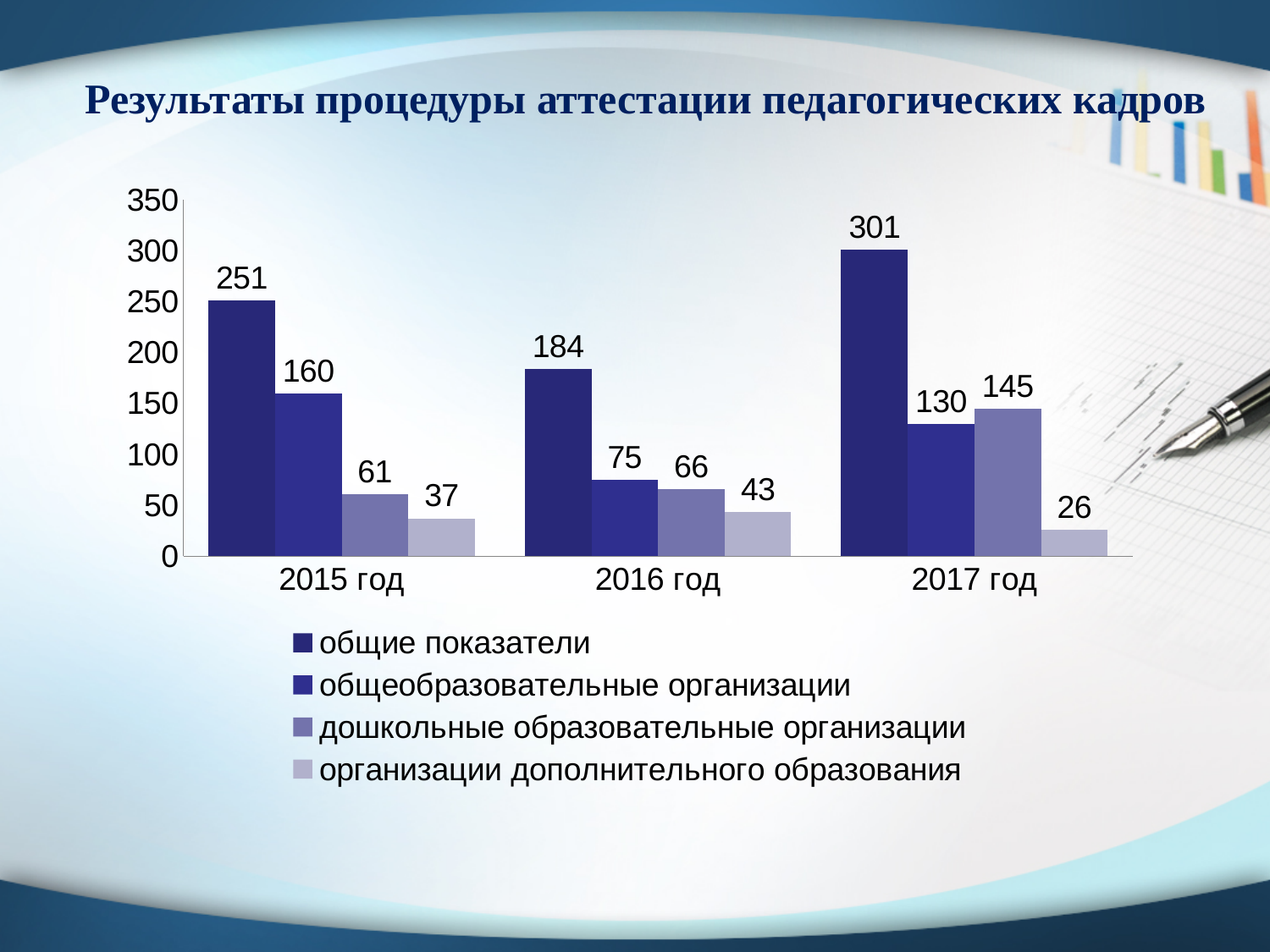
What is the value for дошкольные образовательные организации in 2016 год? 66 Does the value for общеобразовательные организации rise or fall from 2015 год to 2016 год? fall How many series does the legend list? 4 How many year categories are shown on the x axis? 3 Which is larger in 2017 год: общеобразовательные организации or дошкольные образовательные организации? дошкольные образовательные организации What is the value for организации дополнительного образования in 2015 год? 37 In which year is the value for общие показатели the highest? 2017 год What is the difference between общие показатели in 2017 год and in 2016 год? 117 In which year is the value for организации дополнительного образования the lowest? 2017 год What kind of chart is shown on the slide? bar chart What is the value for общие показатели in 2017 год? 301 What is the title of the slide? Результаты процедуры аттестации педагогических кадров